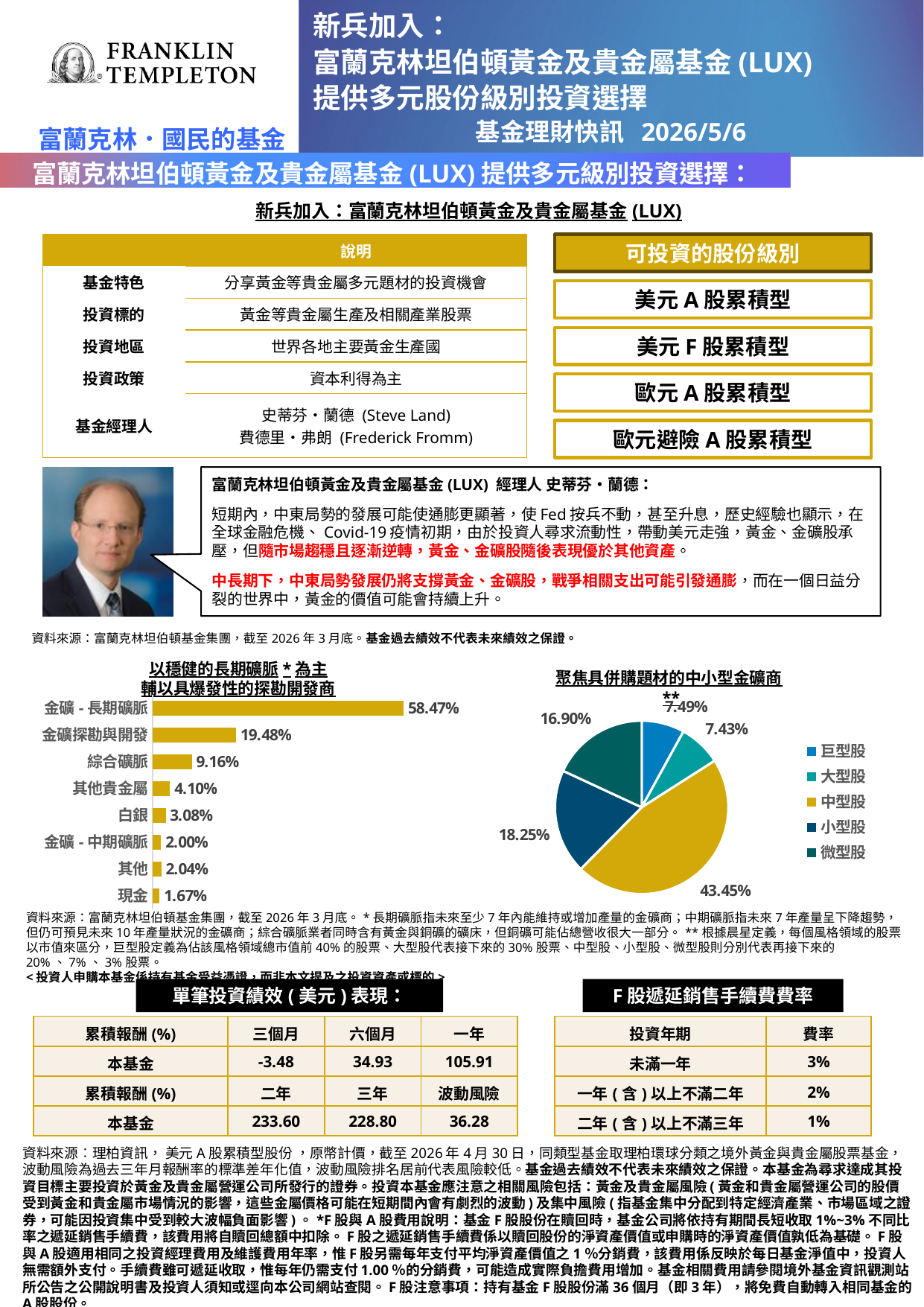
In the pie chart on the right, which is larger: 小型股 or 微型股? 小型股 In the bar chart on the left, which category has the highest value? 金礦 - 長期礦脈 In the bar chart on the left, what is the difference between 金礦 - 長期礦脈 and 金礦探勘與開發? 38.99% In the bar chart on the left, which category has the lowest value? 現金 In the pie chart on the right, how many entries does the legend list? 5 In the pie chart on the right, what is the share for 小型股? 18.25% In the pie chart on the right, what is the share for 中型股? 43.45% In the bar chart on the left, how many categories are shown? 8 In the bar chart on the left, what is the value for 金礦 - 長期礦脈? 58.47% What type of chart is the chart on the left? Bar chart In the bar chart on the left, what is the value for 白銀? 3.08% In the pie chart on the right, which category has the largest slice? 中型股